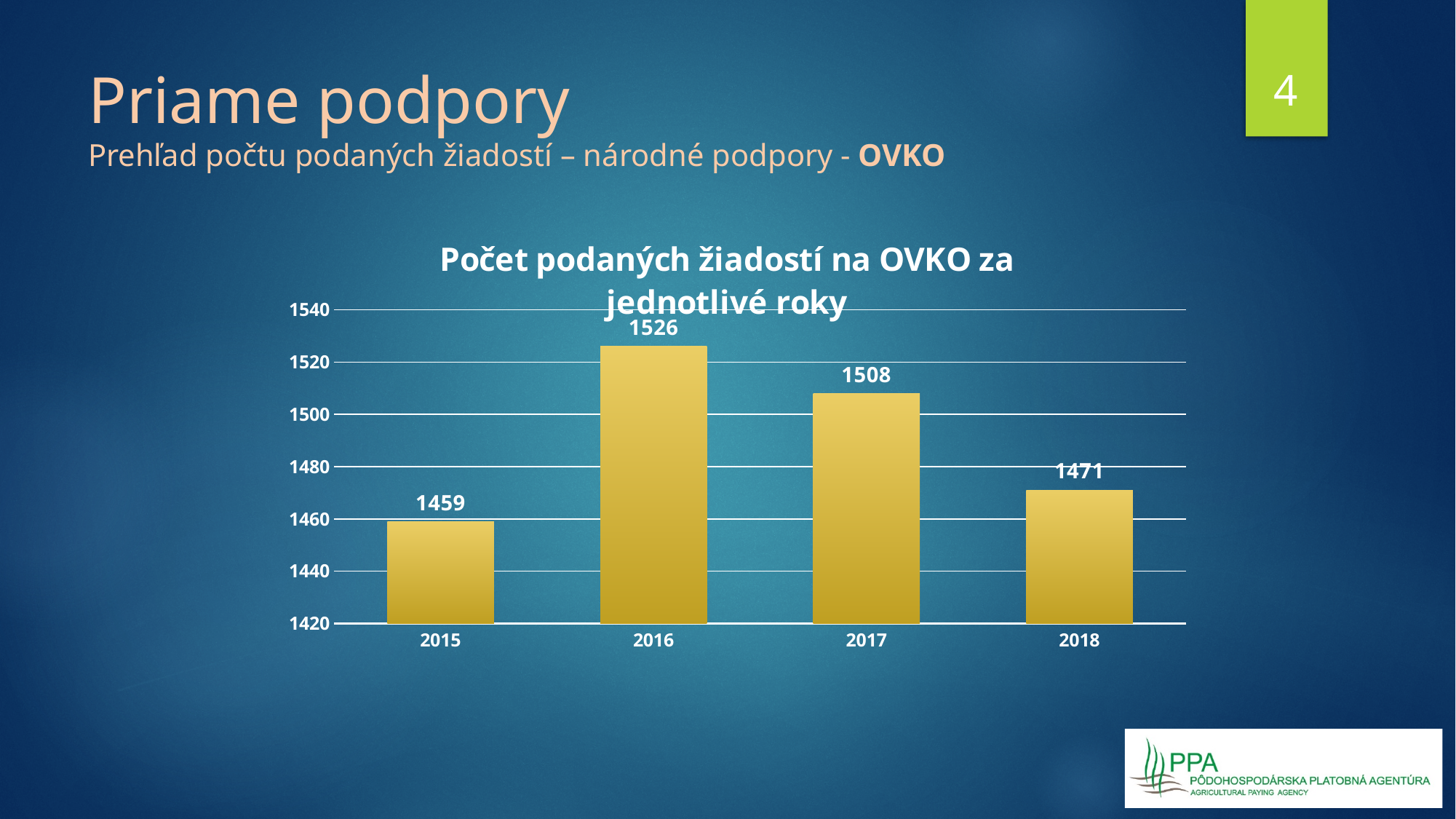
What is the value for 2015? 1459 What is the value for 2017? 1508 How many years are shown on the chart? 4 What kind of chart is shown on the slide? bar chart What is the value for 2016? 1526 Which year has the lowest value? 2015 What is the value for 2018? 1471 Which year has the highest value? 2016 What is the difference between the values for 2017 and 2018? 37 Which is larger, the value for 2017 or the value for 2018? 2017 What is the title of the chart? Počet podaných žiadostí na OVKO za jednotlivé roky What is the difference between the values for 2016 and 2015? 67